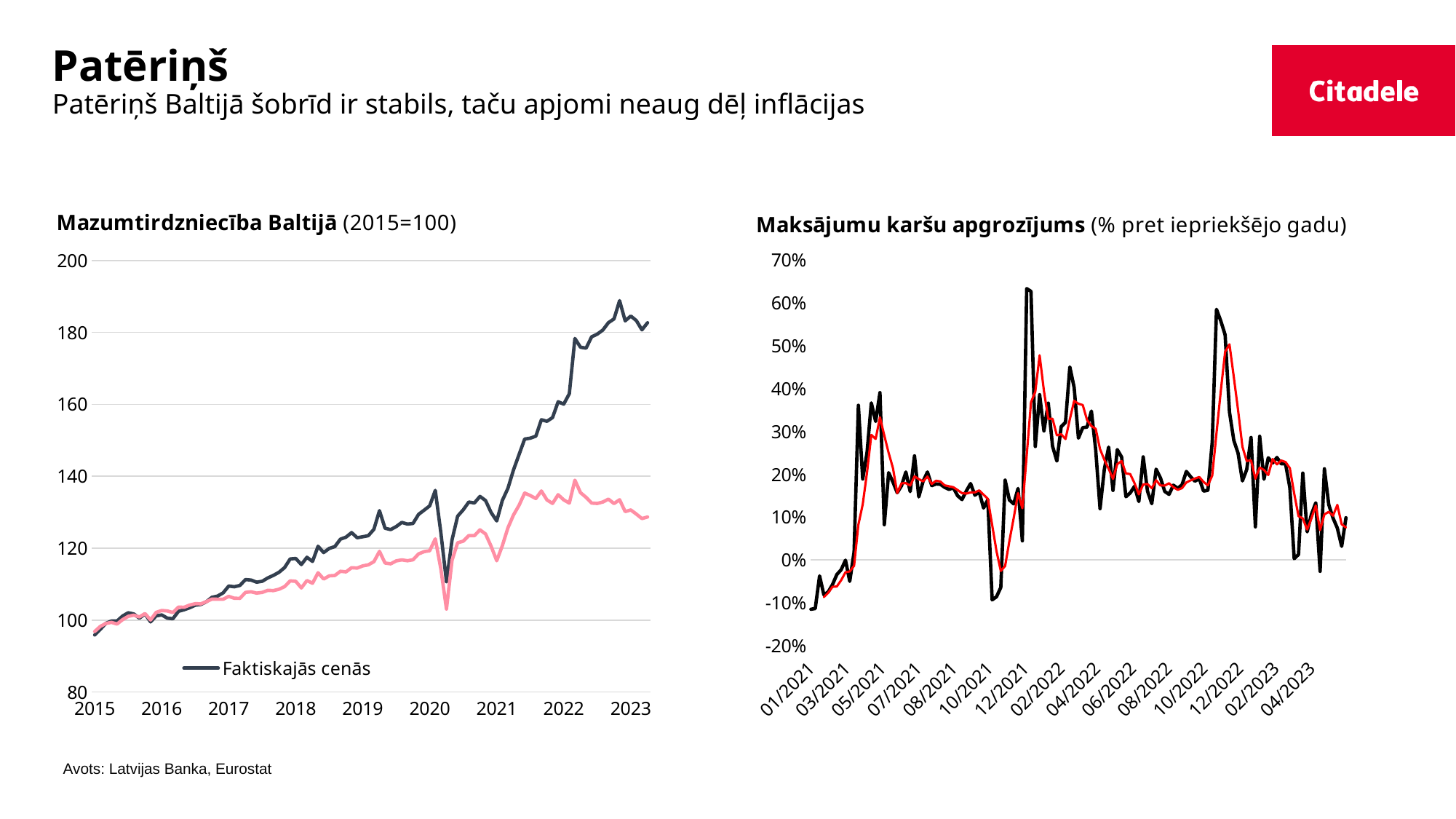
In the right chart 'Maksājumu karšu apgrozījums', does the red line rise or fall between 12/2022 and 04/2023? fall In the left chart 'Mazumtirdzniecība Baltijā', how many series does the legend list? 1 What kind of chart is the left chart, 'Mazumtirdzniecība Baltijā'? line chart In the left chart 'Mazumtirdzniecība Baltijā', does the 'Faktiskajās cenās' line overall rise or fall from 2015 to 2023? rise What kind of chart is the right chart, 'Maksājumu karšu apgrozījums'? line chart In the right chart 'Maksājumu karšu apgrozījums', is the value of the black line at 01/2021 greater or less than 0%? less In the left chart 'Mazumtirdzniecība Baltijā', what is the only series named in the legend? Faktiskajās cenās In the left chart 'Mazumtirdzniecība Baltijā', is the value of the pink line at the end of the series in 2023 greater or less than 140? less What is the title of the right chart? Maksājumu karšu apgrozījums (% pret iepriekšējo gadu) In the right chart 'Maksājumu karšu apgrozījums', is the peak of the black line near 12/2021 greater or less than 60%? greater